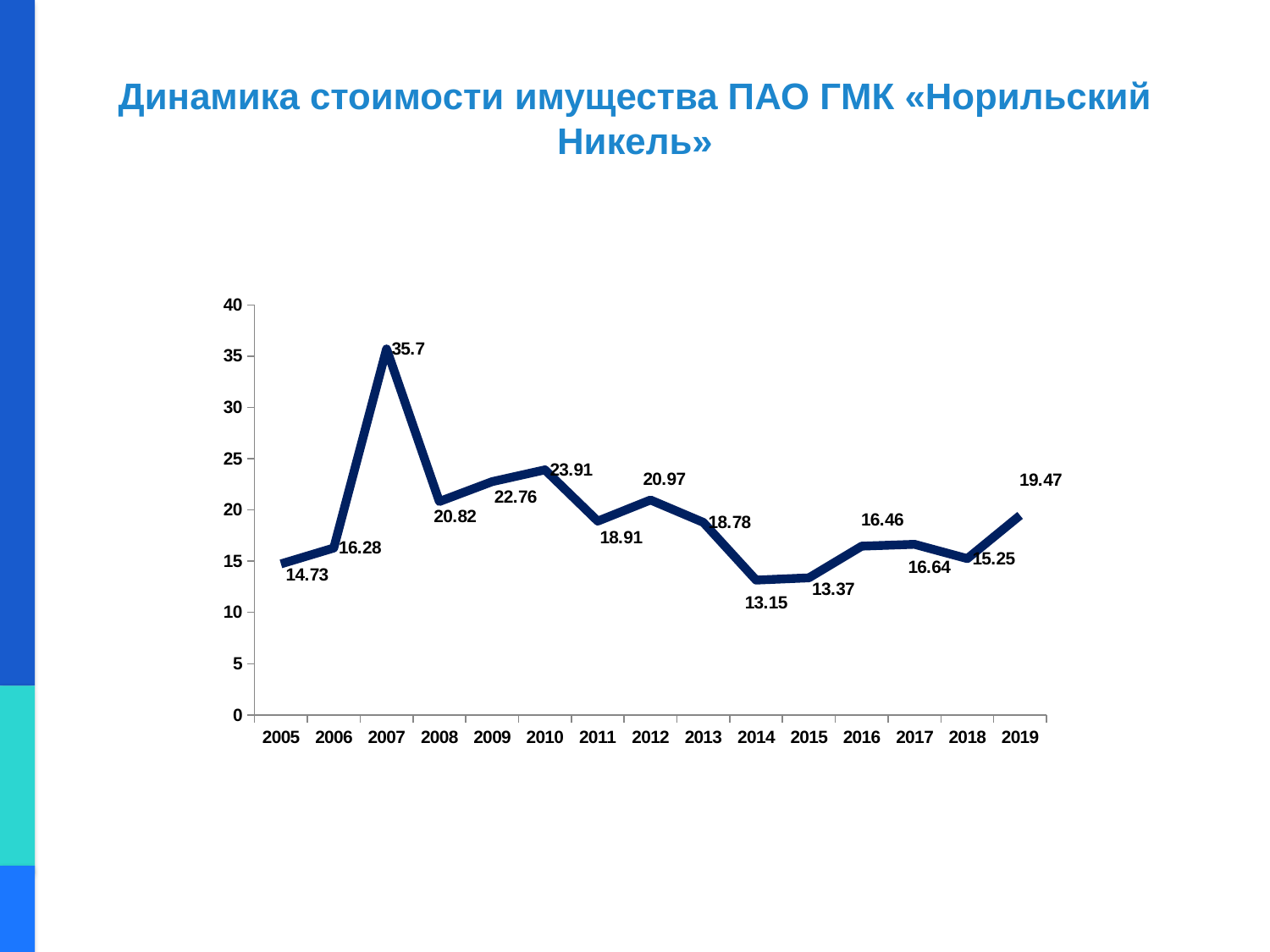
Which year has the lowest value? 2014 Which is larger, the value for 2010 or the value for 2012? 2010 What kind of chart is shown on the slide? line chart Is the value for 2009 greater or less than 20? greater What is the title of the chart? Динамика стоимости имущества ПАО ГМК «Норильский Никель» What is the value for 2014? 13.15 What is the value for 2019? 19.47 What is the difference between the values for 2007 and 2008? 14.88 Do the values rise or fall from 2012 to 2014? fall How many years are plotted on the chart? 15 Which year has the highest value? 2007 What is the value for 2007? 35.7